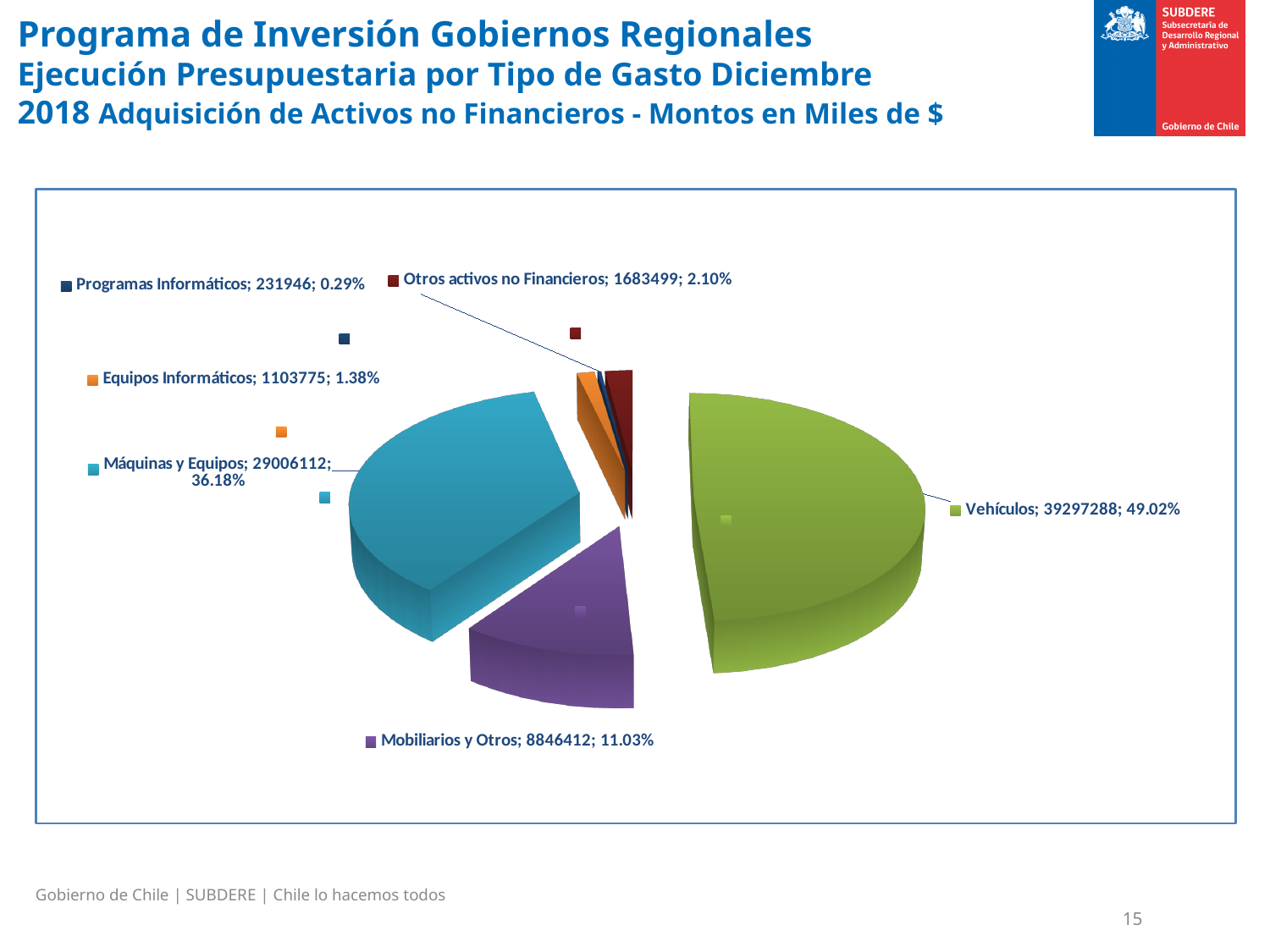
What is the value for Mobiliarios y Otros? 8846412 What percentage share does Máquinas y Equipos have? 36.18% What type of chart is shown on the slide? Pie chart How many categories does the pie chart show? 6 What is the difference between the values for Equipos Informáticos and Programas Informáticos? 871829 What colour is the Vehículos slice? Green What is the difference between the values for Vehículos and Máquinas y Equipos? 10291176 Which category has the largest share of the pie? Vehículos Which is larger, the value for Otros activos no Financieros or Equipos Informáticos? Otros activos no Financieros What is the value for Vehículos? 39297288 Which category has the smallest share of the pie? Programas Informáticos What percentage share does Programas Informáticos have? 0.29%